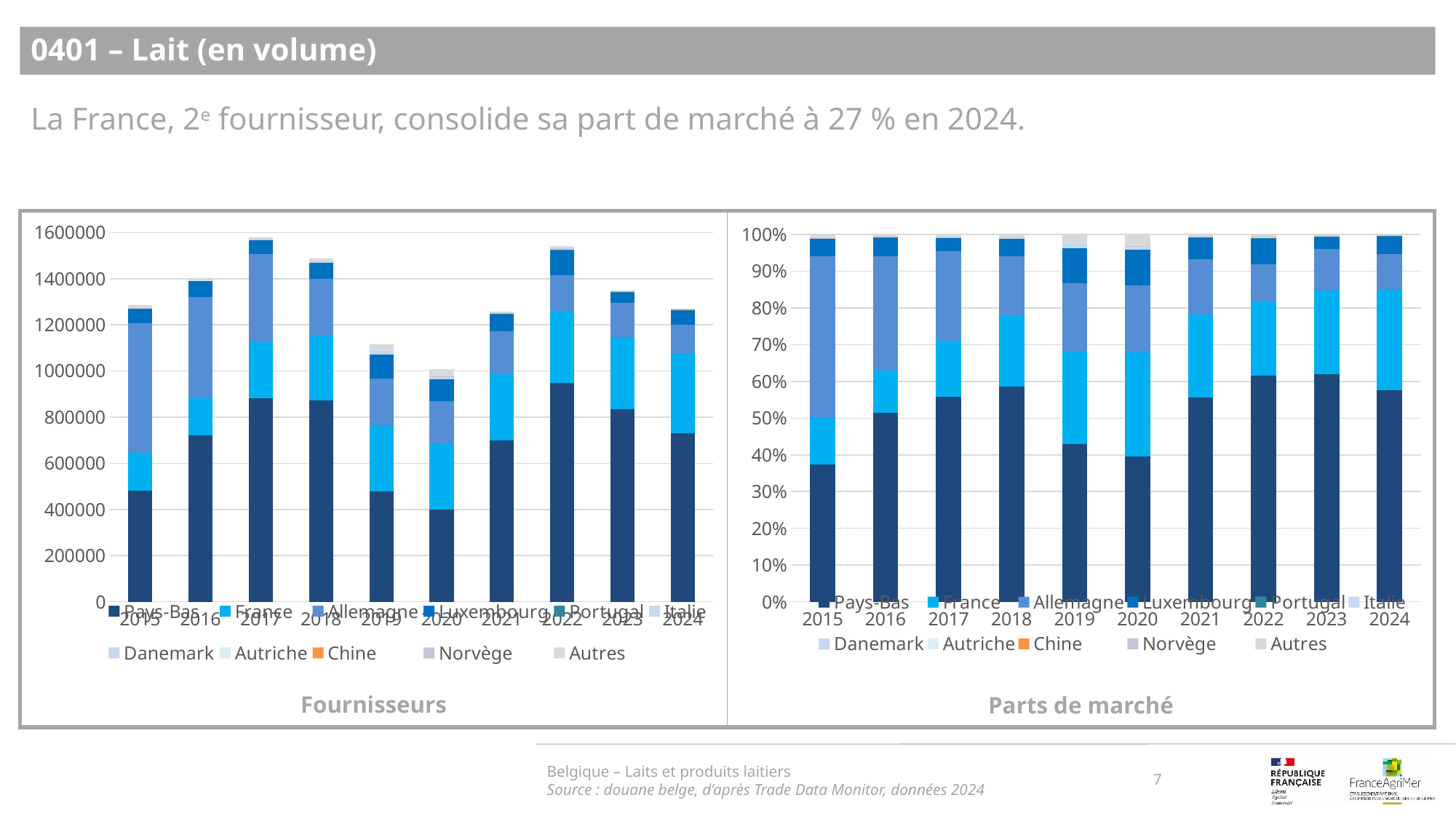
In the 'Fournisseurs' chart, which year has the highest total stacked bar? 2017 In the 'Parts de marché' chart, is the Pays-Bas share in 2023 greater or less than 50%? greater In the 'Fournisseurs' chart, which year has the lowest total stacked bar? 2020 What kind of chart is the 'Fournisseurs' chart on the left? Stacked bar chart In the 'Fournisseurs' chart, is the total for 2020 greater or less than 1200000? less In the 'Parts de marché' chart, does the Pays-Bas share rise or fall from 2020 to 2023? rise In the 'Fournisseurs' chart, is the total for 2017 greater or less than 1400000? greater In the 'Fournisseurs' chart, which total is larger, 2017 or 2019? 2017 How many series does the legend of the 'Fournisseurs' chart list? 11 How many years are shown on the x axis of the 'Parts de marché' chart? 10